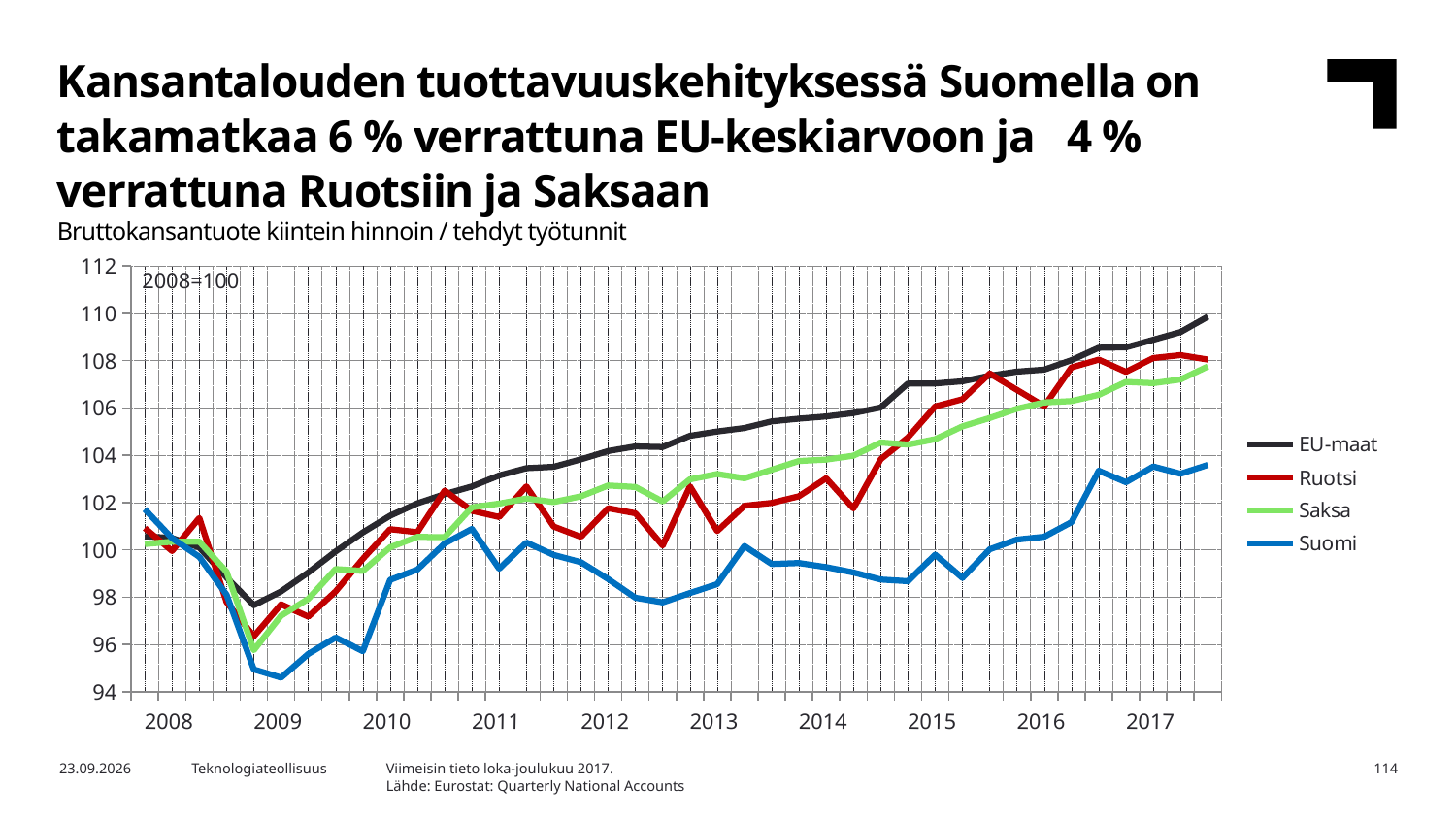
What is the subtitle describing the measure plotted in the chart? Bruttokansantuote kiintein hinnoin / tehdyt työtunnit Which series has the highest value at the end of 2017? EU-maat Which series are listed in the legend? EU-maat, Ruotsi, Saksa, Suomi Is the lowest value for Suomi in 2009 greater or less than 96? less Is the value for EU-maat at the end of 2017 greater or less than 108? greater Is the value for Suomi at the end of 2017 greater or less than 102? greater Does the Suomi series rise or fall from 2015 to 2017? rise How many series does the legend list? 4 What kind of chart is shown on the slide? line chart How many year labels are shown on the x axis? 10 Which series has the lowest value at the end of 2017? Suomi At the end of 2017, which is higher: EU-maat or Suomi? EU-maat